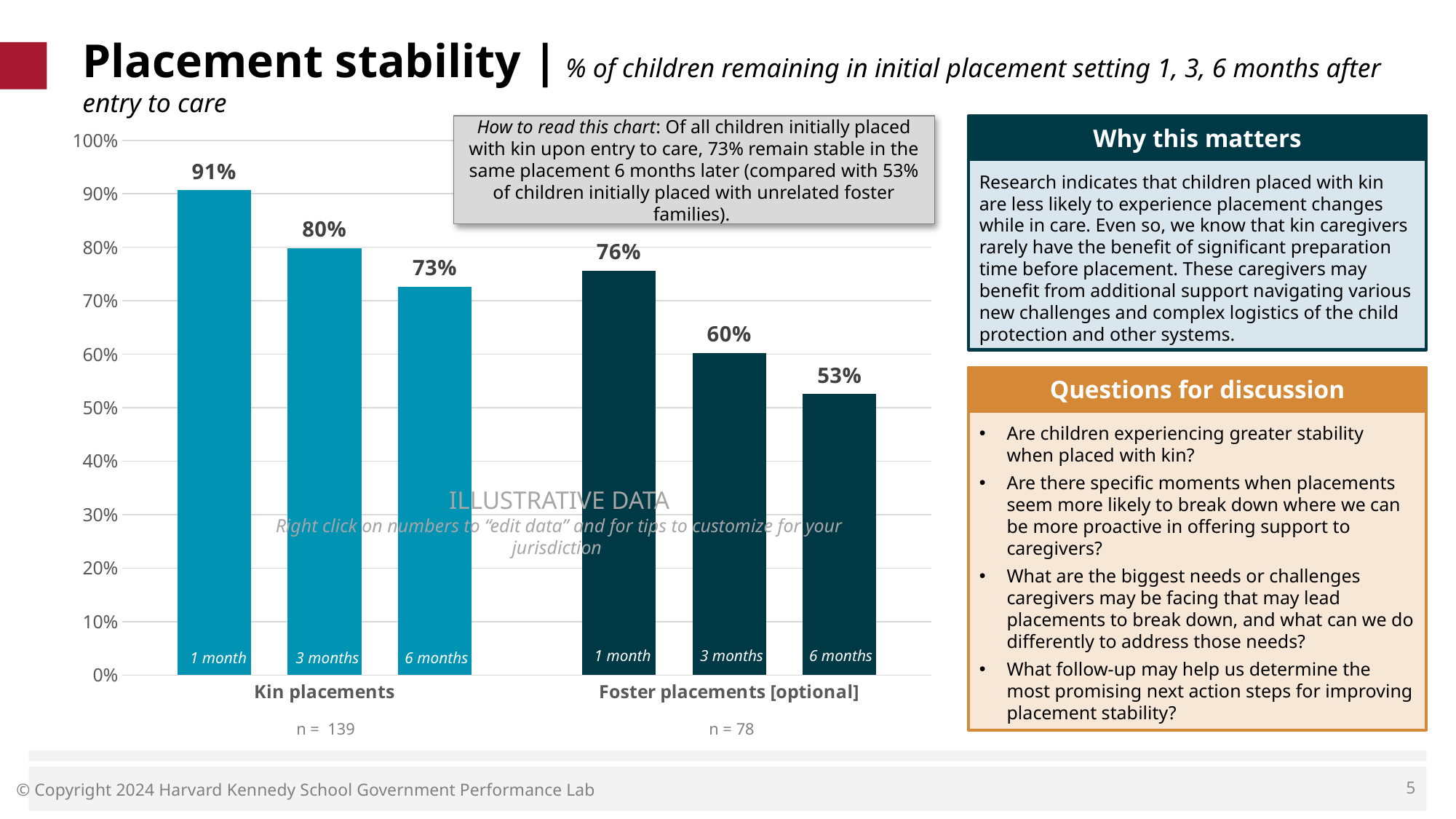
Which is larger: kin placements at 3 months or foster placements at 1 month? Kin placements at 3 months What is the difference between kin placements and foster placements at 6 months? 20 percentage points What type of chart is shown on the slide? Bar chart What percentage of children in kin placements remain in their initial placement 1 month after entry to care? 91% What percentage of children in foster placements remain in their initial placement 6 months after entry to care? 53% What is the value for foster placements at 1 month? 76% How many bars are plotted on the chart? 6 What is the value for kin placements at 3 months? 80% Which bar has the highest value on the chart? Kin placements, 1 month What is the difference between the 1 month and 6 months values for kin placements? 18 percentage points Which bar has the lowest value on the chart? Foster placements, 6 months Do the values for foster placements rise or fall from 1 month to 6 months? Fall